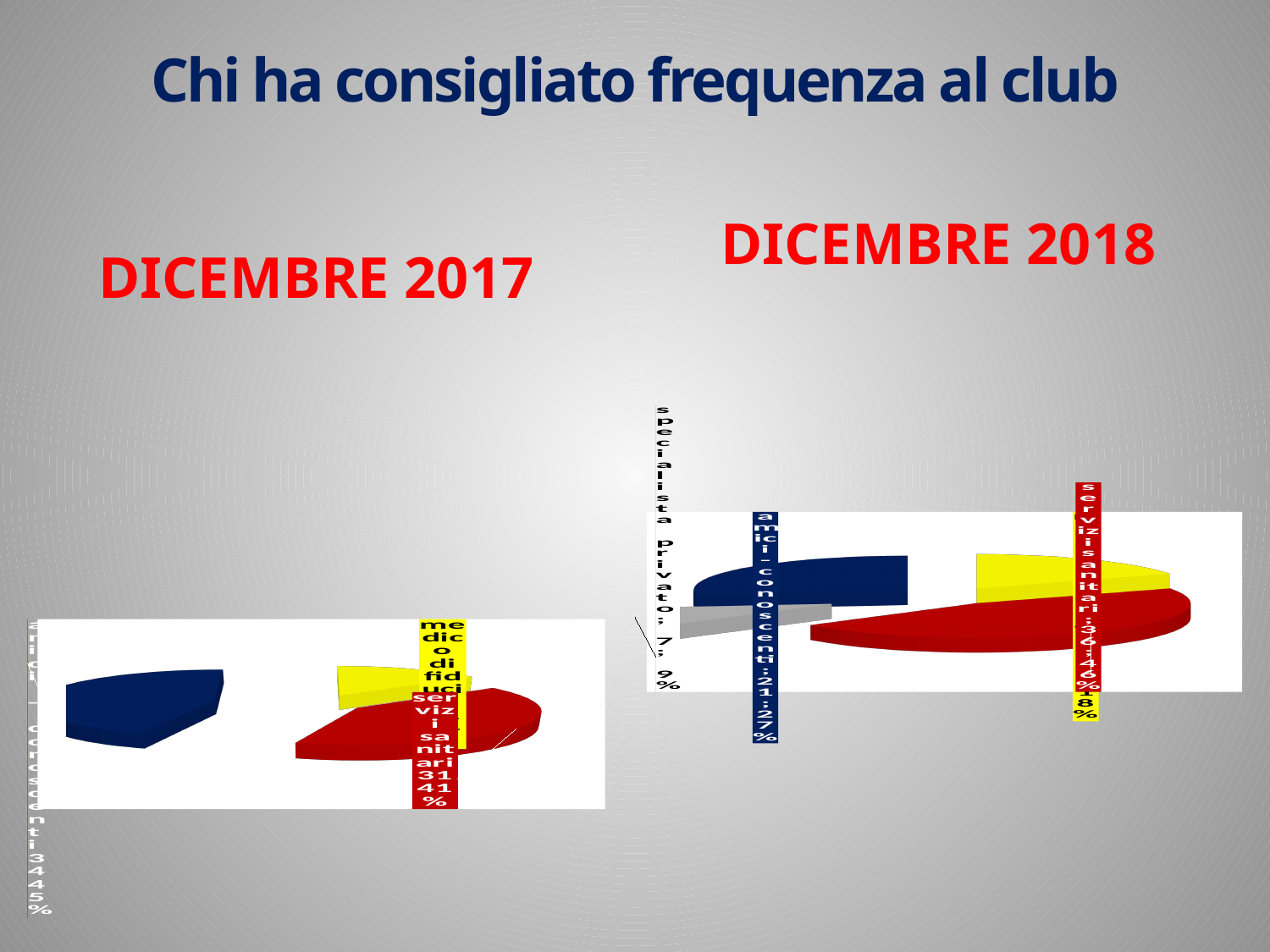
What kind of chart is shown under DICEMBRE 2018? Pie chart How many slices does the DICEMBRE 2017 pie chart have? 3 What kind of chart is shown under DICEMBRE 2017? Pie chart In the DICEMBRE 2018 chart, what colour is the servizi sanitari slice? Red In the DICEMBRE 2018 chart, what share is labelled for servizi sanitari? 46% How many slices does the DICEMBRE 2018 pie chart have? 4 In the DICEMBRE 2018 chart, which category has the smallest labelled share? specialista privato In the DICEMBRE 2017 chart, what share is labelled for servizi sanitari? 41% Is the share for servizi sanitari larger in the DICEMBRE 2017 chart or the DICEMBRE 2018 chart? DICEMBRE 2018 In the DICEMBRE 2018 chart, what share is labelled for specialista privato? 9% In the DICEMBRE 2018 chart, what share is labelled for amici - conoscenti? 27% In the DICEMBRE 2018 chart, which is larger: servizi sanitari or amici - conoscenti? servizi sanitari